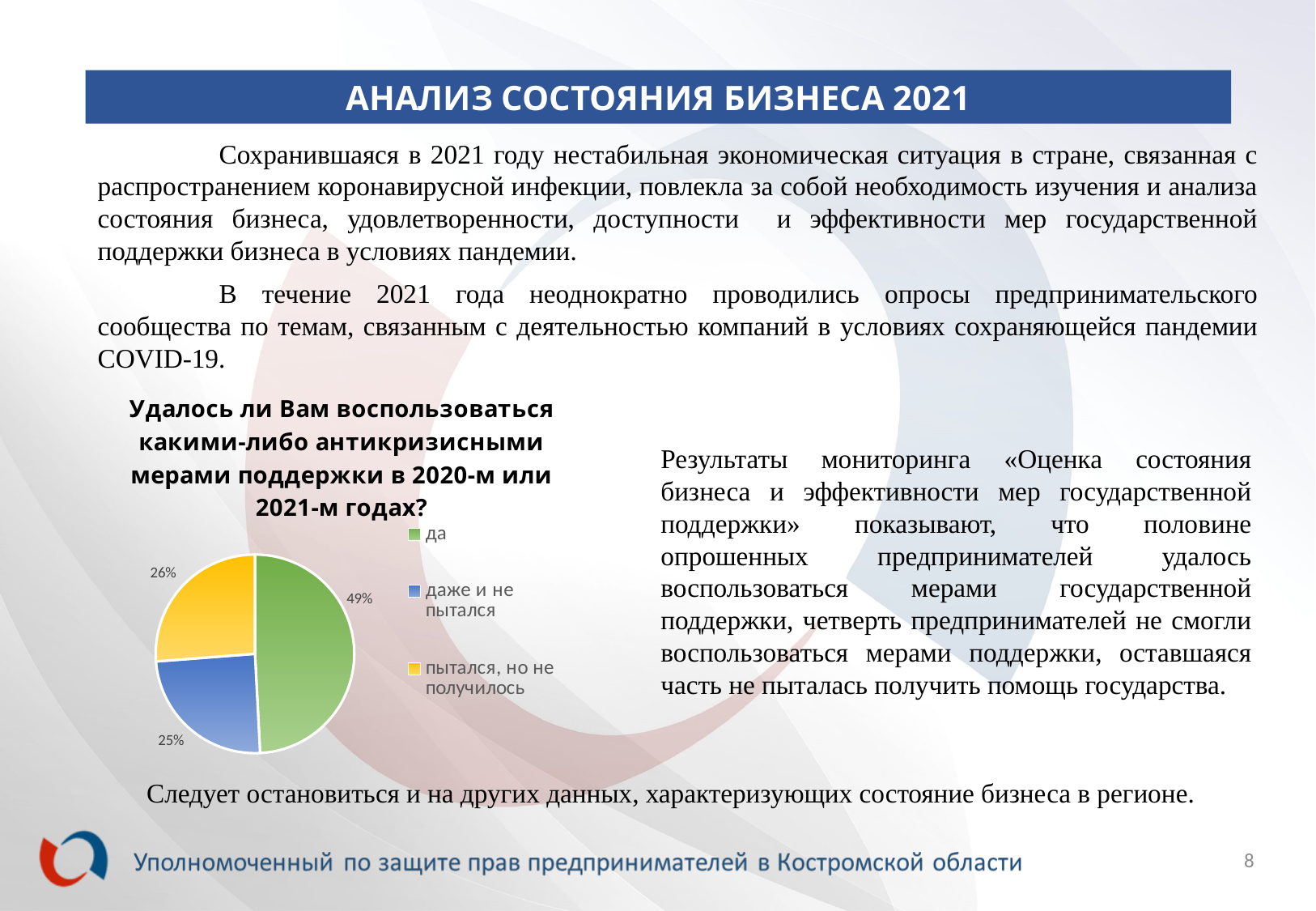
How many entries does the legend of the pie chart list? 3 What share of respondents answered "пытался, но не получилось"? 26% What is the difference in percentage points between the "да" slice and the "даже и не пытался" slice? 24 Which answer option has the largest share of the pie? да What kind of chart is shown on the slide? pie chart What is the title of the pie chart? Удалось ли Вам воспользоваться какими-либо антикризисными мерами поддержки в 2020-м или 2021-м годах? How many slices does the pie chart have? 3 What share of respondents answered "даже и не пытался"? 25% What share of respondents answered "да"? 49% What colour is the "да" slice of the pie chart? green Which is larger: the share for "да" or the share for "пытался, но не получилось"? да Which answer option has the smallest share of the pie? даже и не пытался